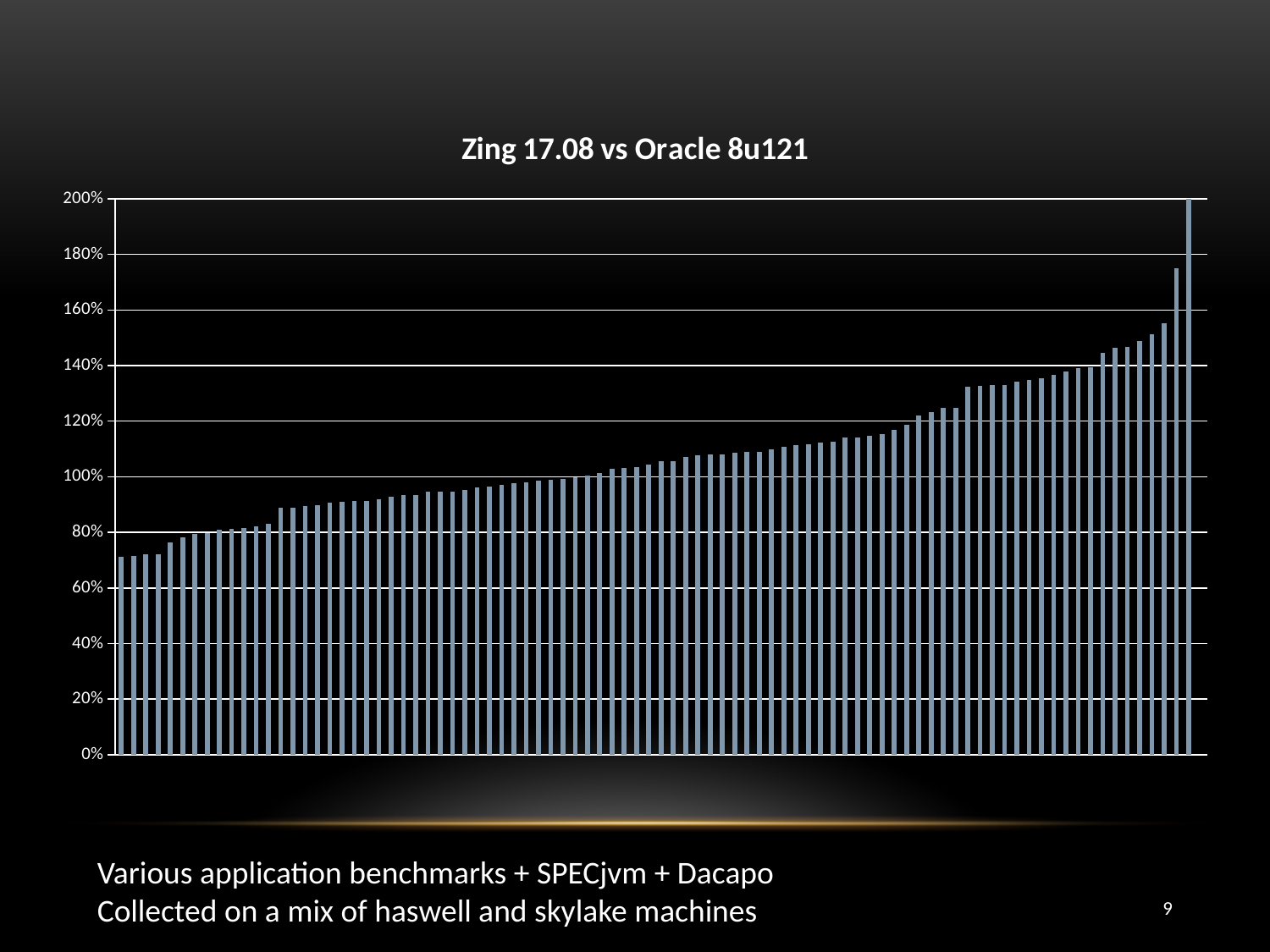
Is the value of the rightmost bar greater or less than 180%? greater What kind of chart is shown on the slide? bar chart Do the bar values rise or fall from left to right along the x axis? rise Is the value of the second bar from the right greater or less than 160%? greater Is the value of the leftmost bar greater or less than 60%? greater Which bar is the tallest, the leftmost bar or the rightmost bar? the rightmost bar What is the highest value shown on the vertical axis? 200% What is the title of the chart? Zing 17.08 vs Oracle 8u121